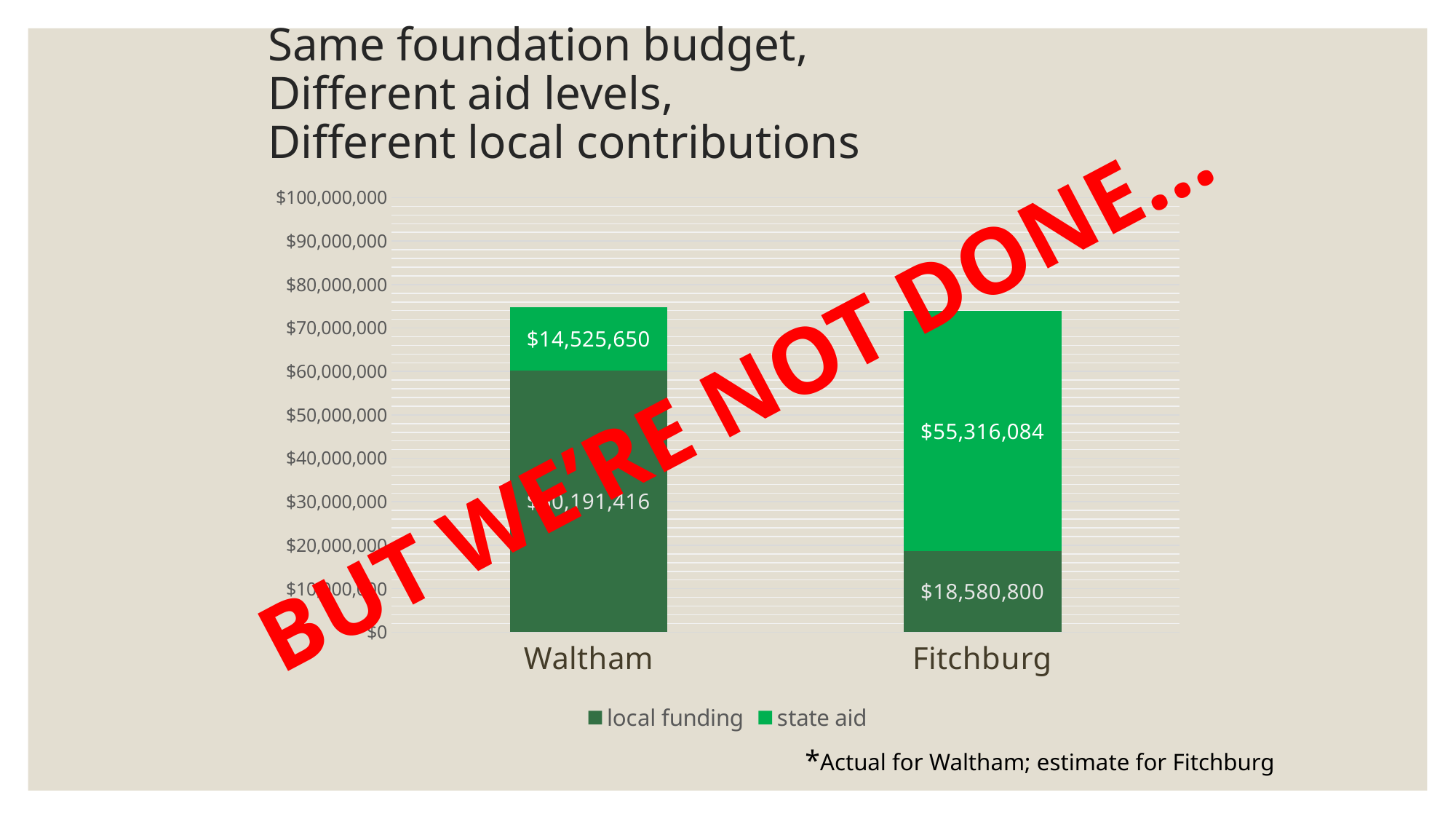
What is the total of the Fitchburg stacked bar (local funding plus state aid)? $73,896,884 What is the local funding value for Fitchburg? $18,580,800 How many series does the legend list? 2 What is the state aid value for Waltham? $14,525,650 Is the total height of the Waltham bar greater or less than $70,000,000? greater Which district receives more state aid, Waltham or Fitchburg? Fitchburg How many districts are shown on the x axis? 2 Which district has the higher local funding? Waltham What does the footnote below the chart say? *Actual for Waltham; estimate for Fitchburg What kind of chart is shown on the slide? stacked bar chart What is the state aid value for Fitchburg? $55,316,084 What is the difference between Fitchburg's state aid and Waltham's state aid? $40,790,434